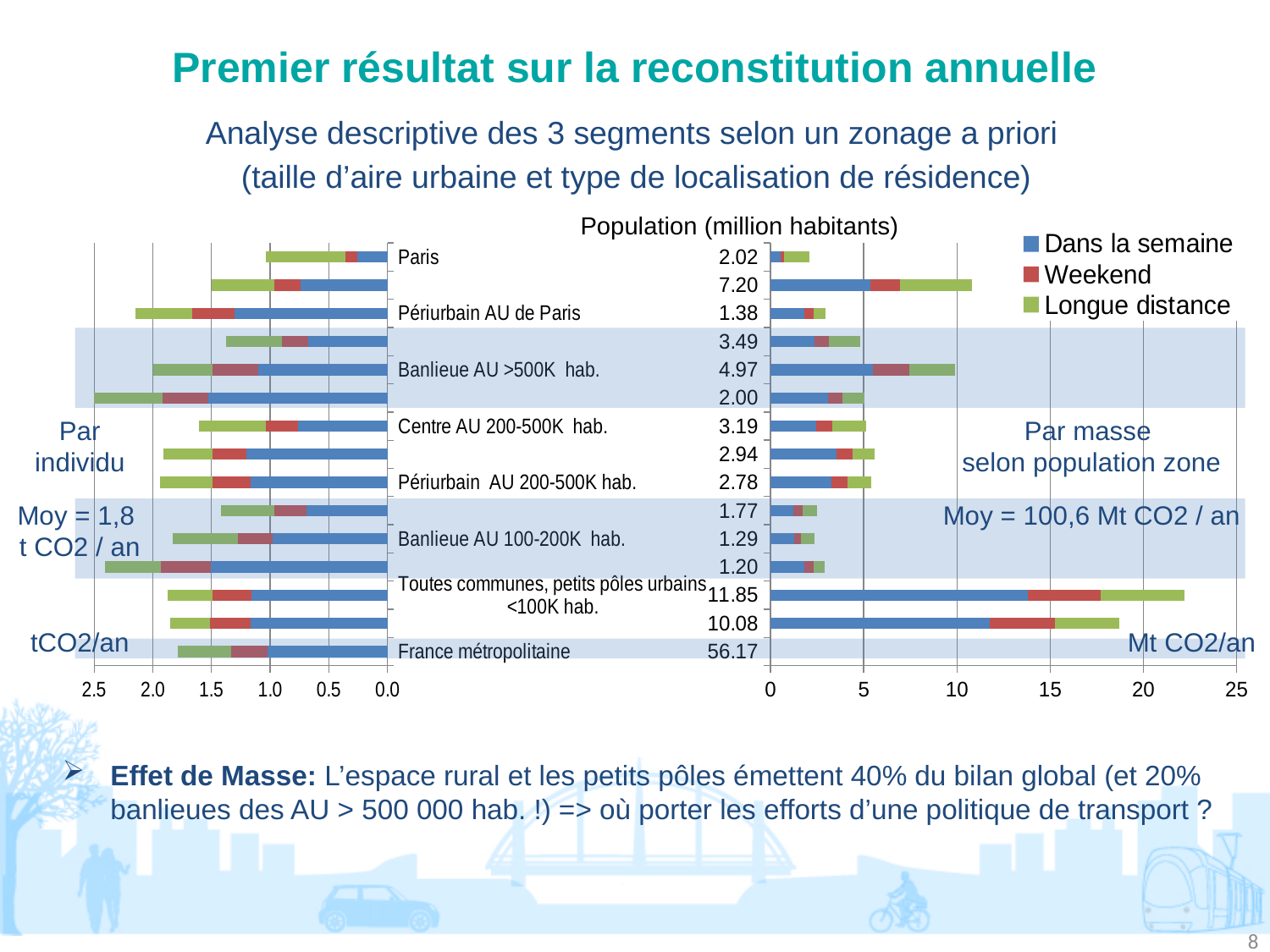
Which colour represents 'Longue distance' in the legend? Green In the right chart, which row has the longer total bar: the row with population 11.85 or the row with population 2.02? The row with population 11.85 How many series does the legend list? 3 What population (million habitants) is printed for the Paris row? 2.02 What kind of chart is the left chart labelled 'Par individu'? Stacked bar chart What population (million habitants) is printed for the Banlieue AU >500K hab. row? 4.97 What is the maximum value shown on the x axis of the right chart (Mt CO2/an)? 25 In the right chart 'Par masse selon population zone', is the total bar for the row with population 10.08 greater or less than 20? less What are the three series named in the legend? Dans la semaine, Weekend, Longue distance In the right chart 'Par masse selon population zone', is the total bar for the row with population 11.85 greater or less than 20? greater In the left chart 'Par individu', is the total bar for France métropolitaine greater or less than 1.5 tCO2/an? greater What population (million habitants) is printed for France métropolitaine? 56.17